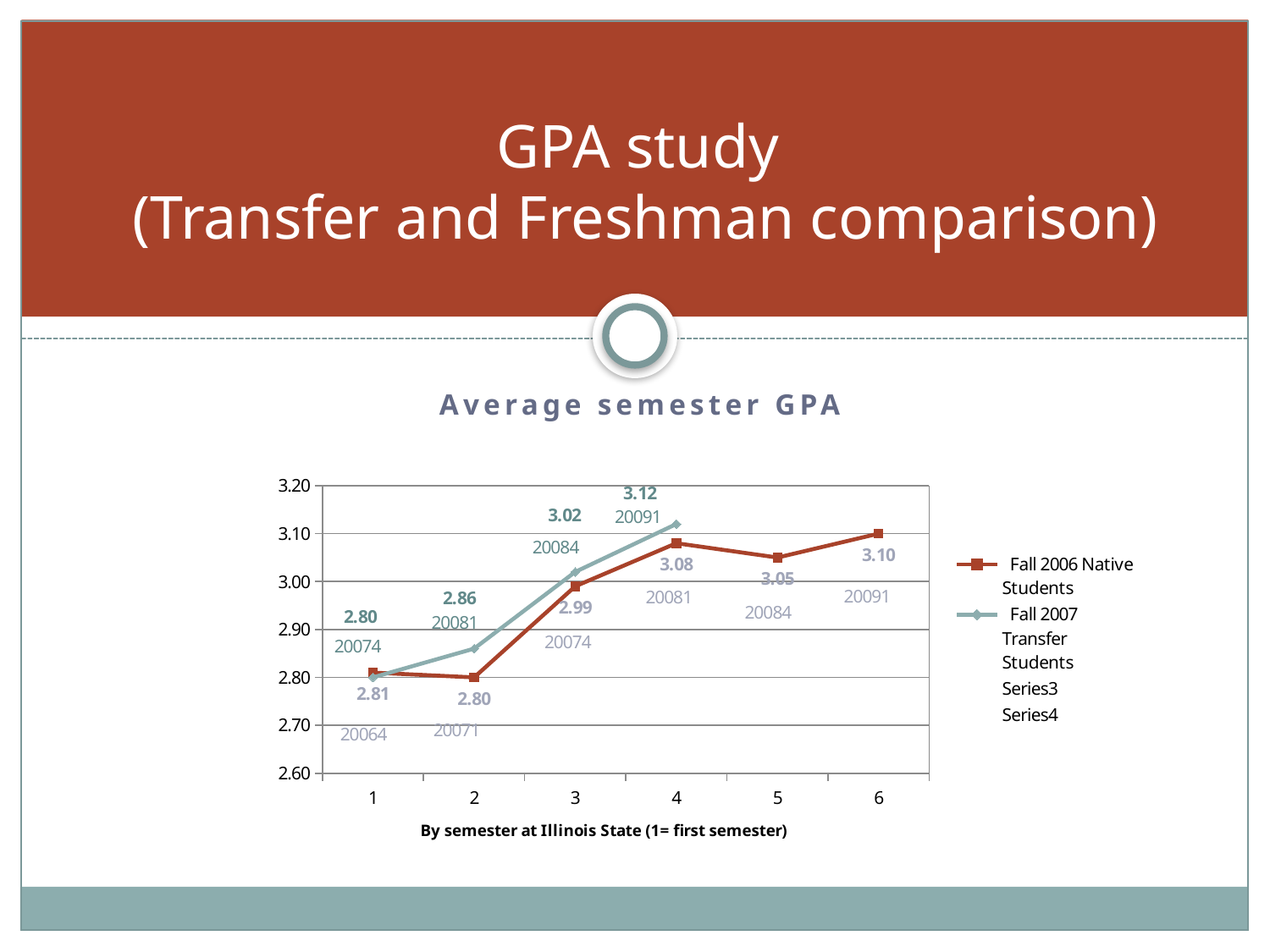
How many semesters are shown on the x axis? 6 In which semester do Fall 2006 Native Students have their highest average GPA? Semester 6 What is the average GPA for Fall 2006 Native Students in semester 6? 3.10 What kind of chart is shown on the slide? Line chart Does the average GPA for Fall 2007 Transfer Students rise or fall from semester 1 to semester 4? Rise In semester 4, how much higher is the Fall 2007 Transfer Students' GPA than the Fall 2006 Native Students' GPA? 0.04 What is the average GPA for Fall 2006 Native Students in semester 1? 2.81 How many entries does the legend list? 4 In which semester do Fall 2006 Native Students have their lowest average GPA? Semester 2 What is the average GPA for Fall 2007 Transfer Students in semester 2? 2.86 What is the average GPA for Fall 2007 Transfer Students in semester 4? 3.12 In semester 3, which group has the higher average GPA, Fall 2006 Native Students or Fall 2007 Transfer Students? Fall 2007 Transfer Students